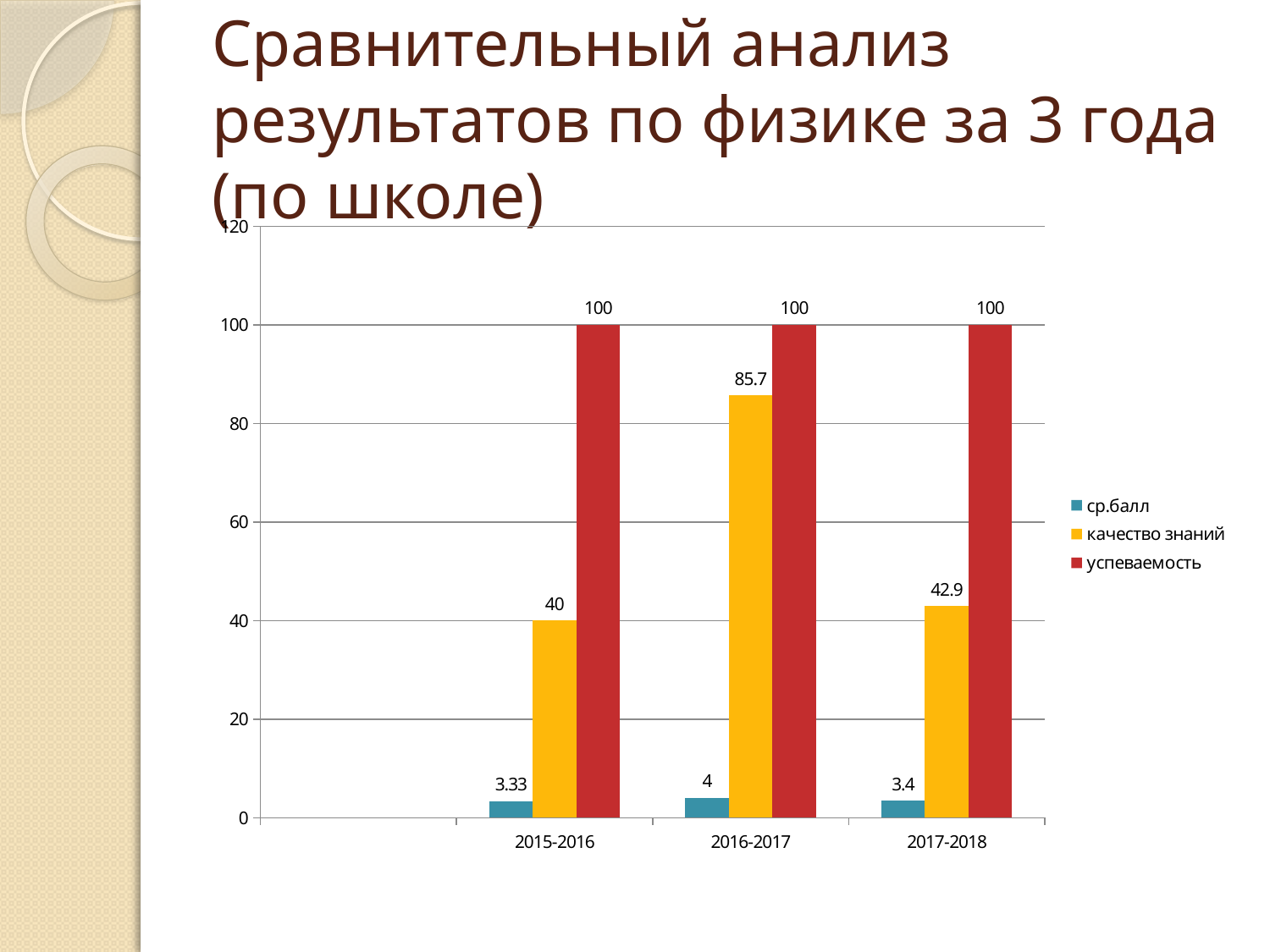
What is the difference between качество знаний in 2016-2017 and in 2017-2018? 42.8 Which colour represents качество знаний in the legend? yellow Does успеваемость rise, fall or stay the same across the three years? stays the same In which year is качество знаний highest? 2016-2017 What is the value of ср.балл for 2015-2016? 3.33 What kind of chart is shown on the slide? bar chart Which is larger: качество знаний in 2015-2016 or in 2017-2018? 2017-2018 What is the value of качество знаний for 2016-2017? 85.7 How many year categories are shown on the x axis? 3 What is the value of успеваемость for 2017-2018? 100 How many series does the legend list? 3 In which year is ср.балл lowest? 2015-2016